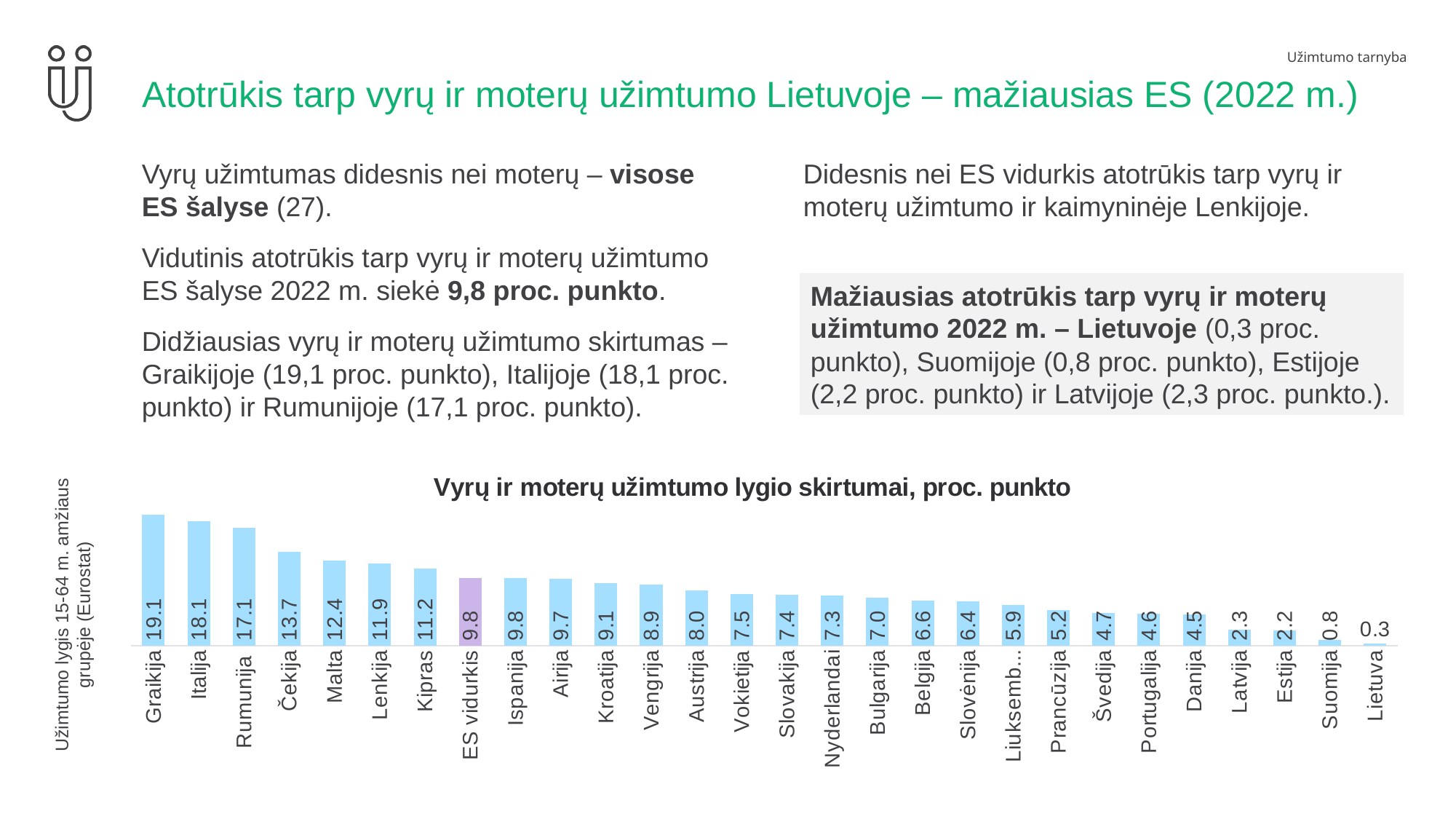
Which category has the lowest value? Lietuva What is the difference between the values for Italija and Rumunija? 1.0 What type of chart is shown on the slide? bar chart How many bars are plotted in the chart? 28 Which has a larger value, Malta or Kipras? Malta Which category has the highest value? Graikija Do the values rise or fall moving from left to right along the x axis? fall What is the value for ES vidurkis? 9.8 What is the value for Lenkija? 11.9 What is the title of the chart? Vyrų ir moterų užimtumo lygio skirtumai, proc. punkto What is the value for Lietuva? 0.3 What is the value for Graikija? 19.1